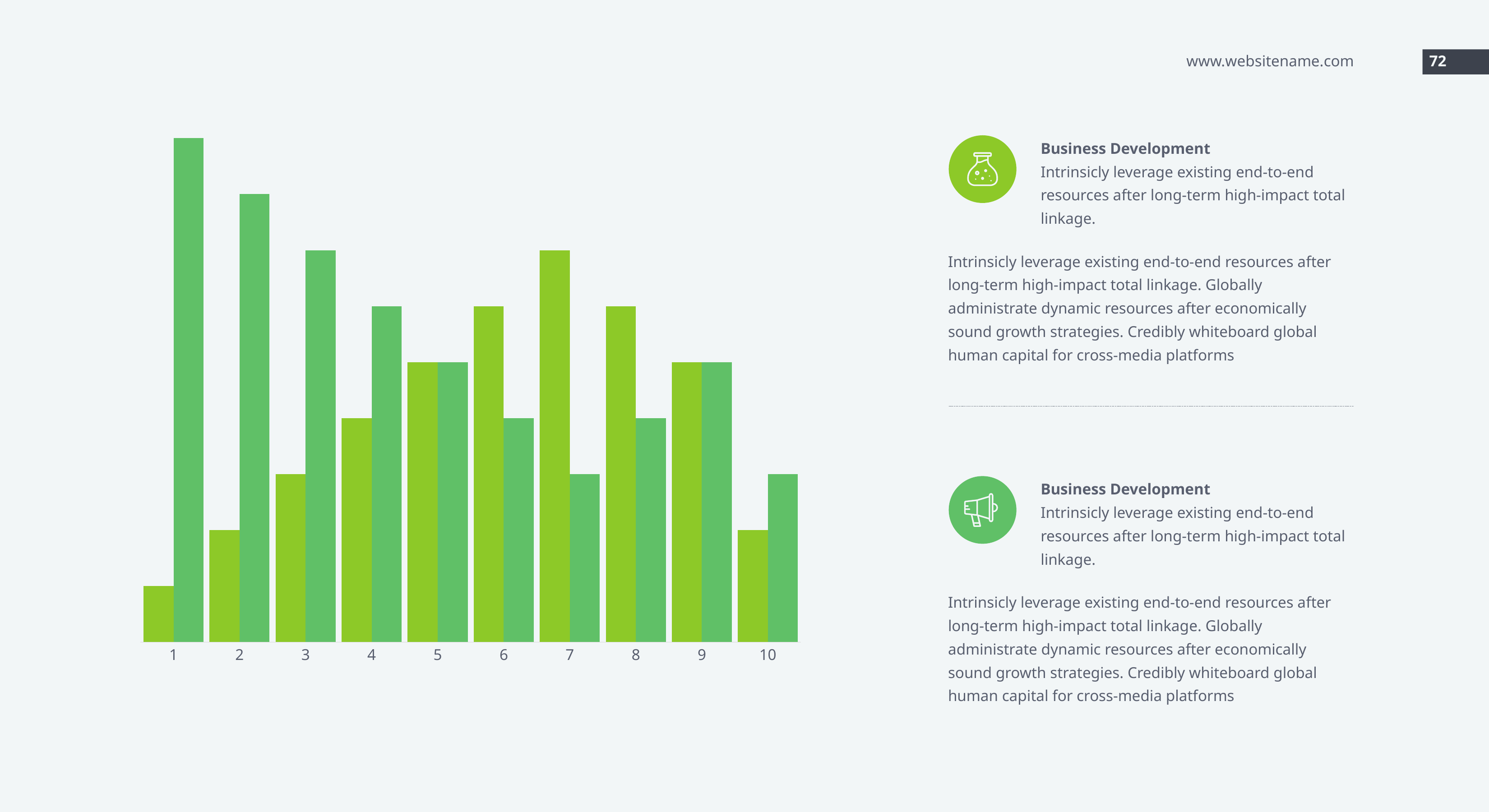
In which category is the light green bar the tallest? 7 In category 7, which bar is taller, the light green bar or the darker green bar? the light green bar In which category is the light green bar the shortest? 1 Do the light green bars rise or fall from category 1 to category 7? rise How many categories are shown along the x axis of the chart? 10 What kind of chart is shown on the slide? bar chart In which category is the tallest bar of the whole chart? 1 In category 1, which bar is taller, the light green bar or the darker green bar? the darker green bar In category 10, which bar is taller, the light green bar or the darker green bar? the darker green bar Do the darker green bars rise or fall from category 1 to category 6? fall What two colours are used for the bars in the chart? light green and darker green How many bars are plotted for each category in the chart? 2